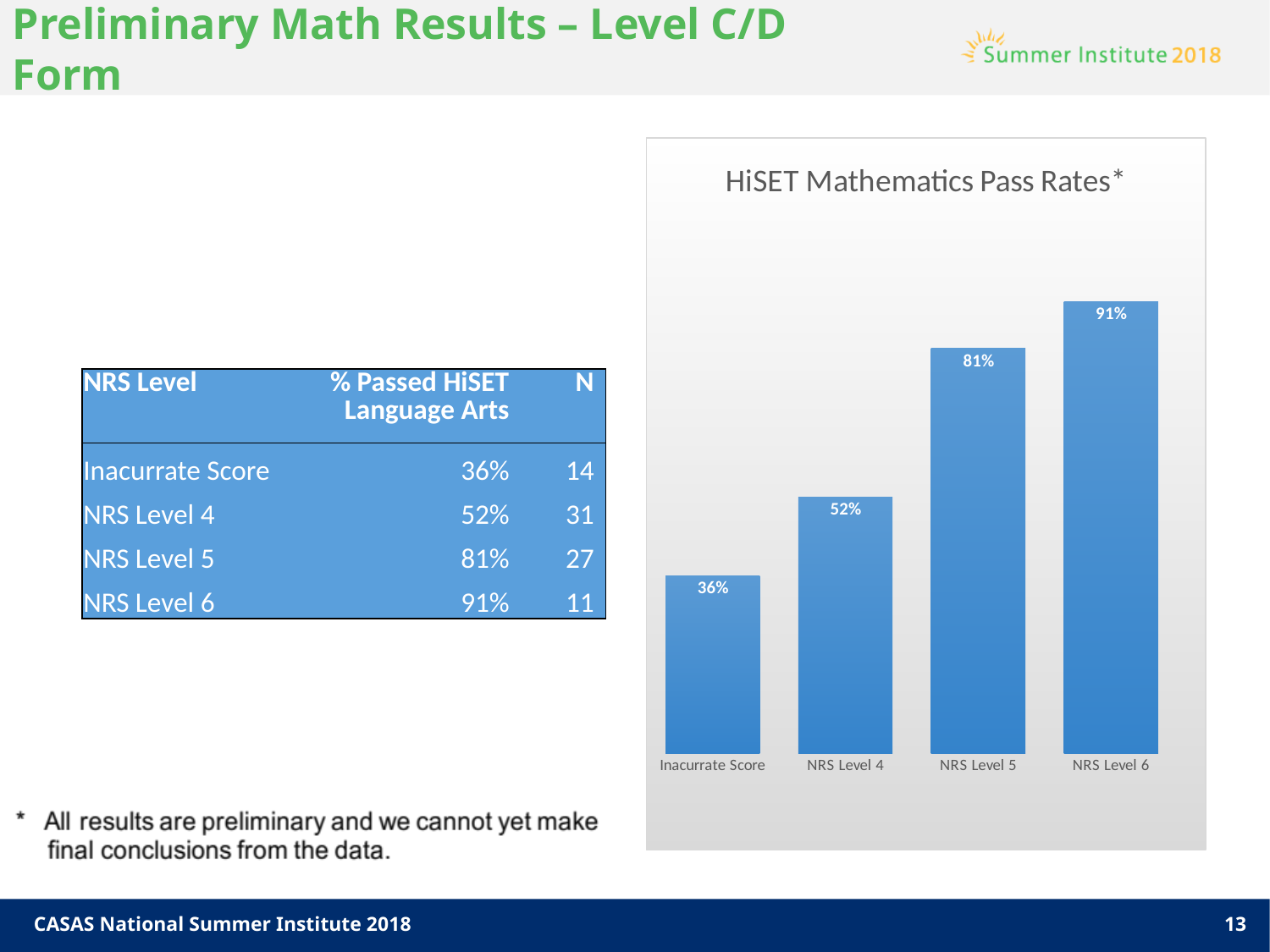
How many categories are shown in the chart? 4 Which category has the lowest HiSET Mathematics pass rate? Inacurrate Score What is the HiSET Mathematics pass rate for NRS Level 4? 52% Which category has the highest HiSET Mathematics pass rate? NRS Level 6 What is the HiSET Mathematics pass rate for NRS Level 6? 91% What is the title of the chart? HiSET Mathematics Pass Rates* What is the difference between the pass rates for NRS Level 5 and NRS Level 4? 29% Which has a higher pass rate, NRS Level 5 or NRS Level 4? NRS Level 5 What kind of chart is shown on the slide? Bar chart What is the difference between the pass rates for NRS Level 6 and Inacurrate Score? 55% Do the pass rates rise or fall from left to right across the categories? Rise What is the HiSET Mathematics pass rate for the Inacurrate Score category? 36%